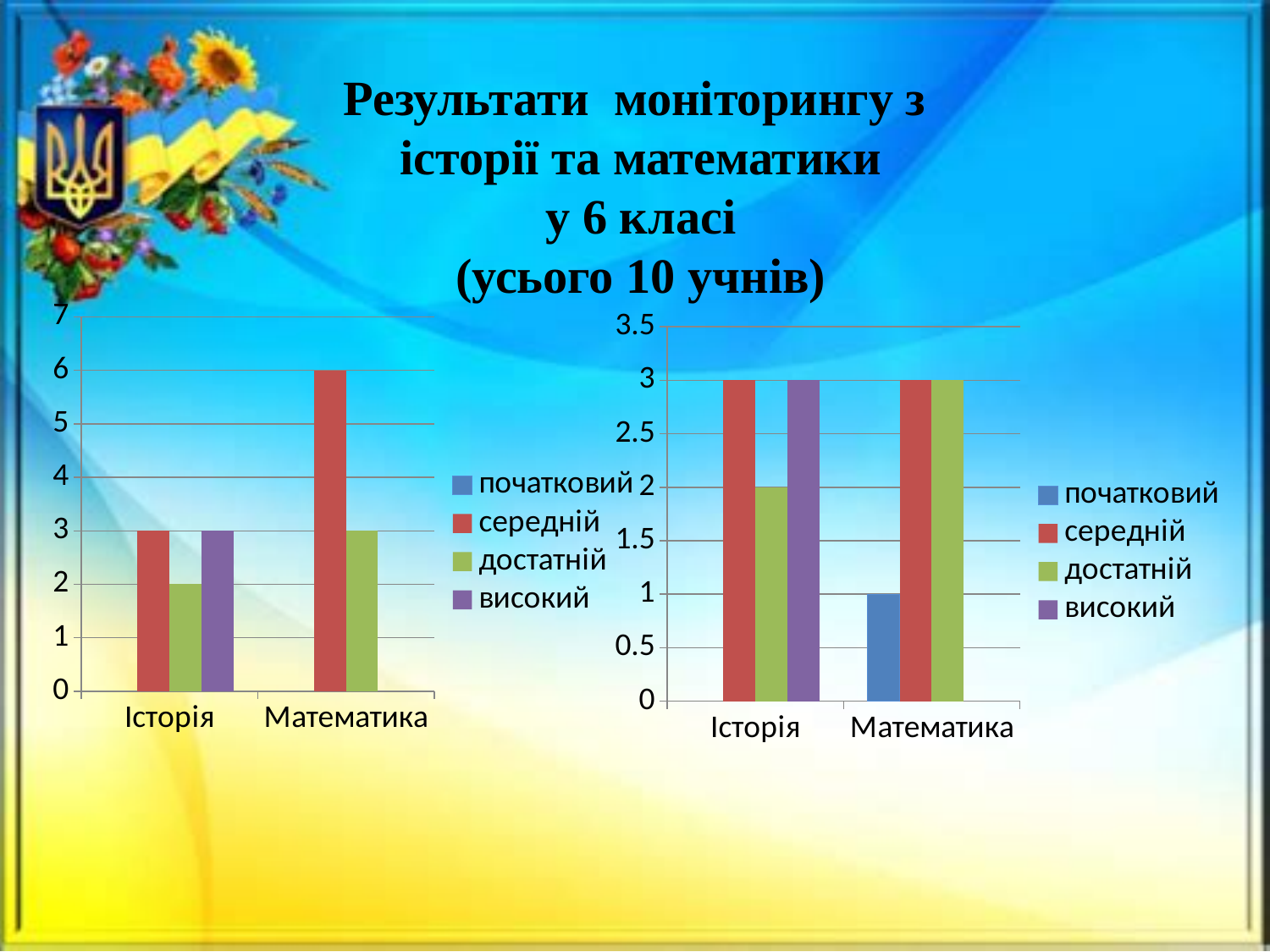
On the right chart, which is larger: достатній for Історія or достатній for Математика? достатній for Математика How many categories are shown on the x axis of the right chart? 2 On the right chart, what is the value of початковий for Математика? 1 On the left chart, what is the value of середній for Математика? 6 How many series does the legend of the left chart list? 4 On the right chart, what is the highest value shown on the y axis? 3.5 On the left chart, what is the value of достатній for Історія? 2 On the right chart, which series has the lowest bar for Математика? початковий On the right chart, what is the value of достатній for Історія? 2 On the left chart, what is the difference between середній for Математика and середній for Історія? 3 What type of chart is the left chart? bar chart On the left chart, which series has the highest bar for Математика? середній